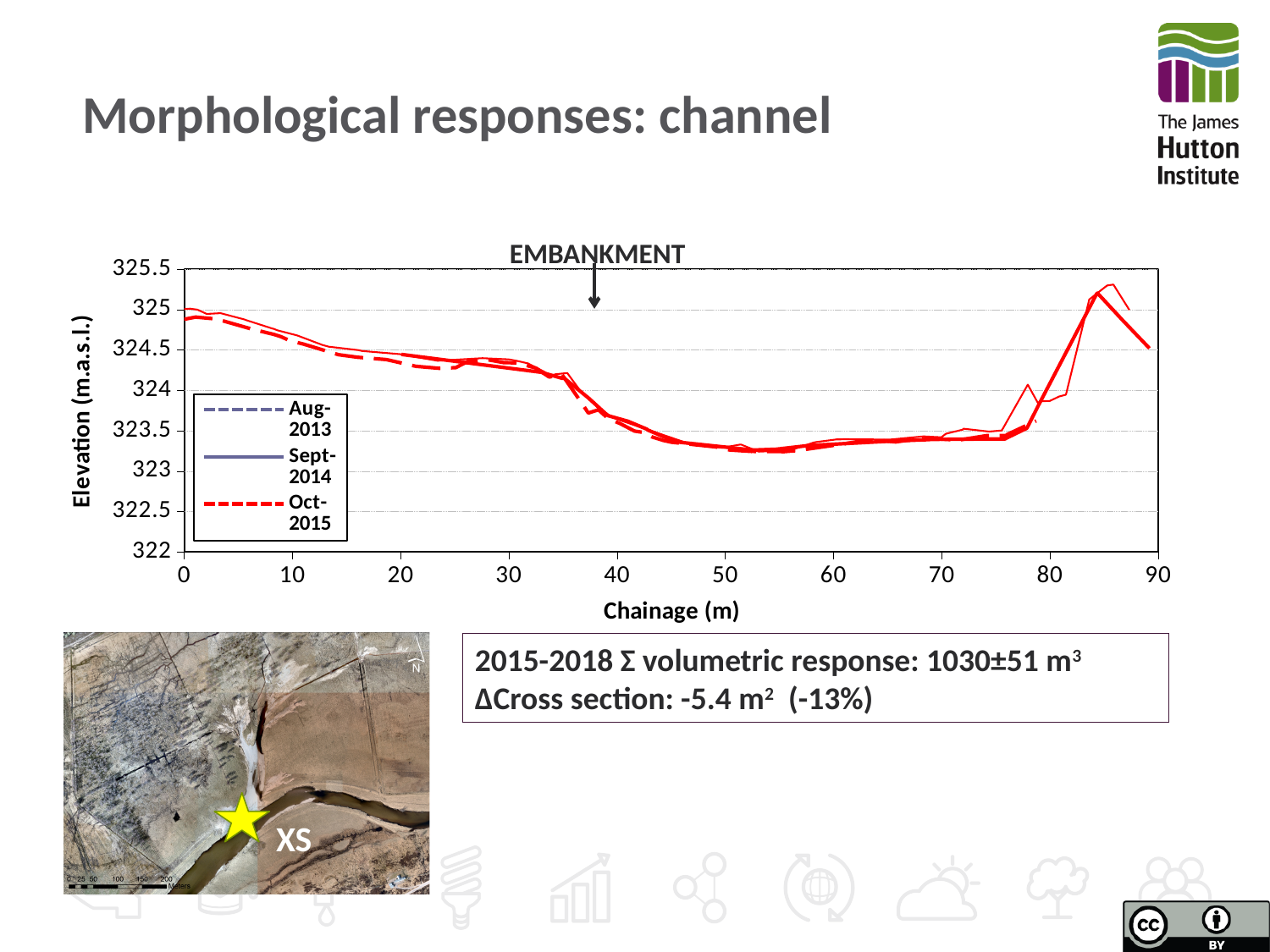
Is the Oct-2015 elevation at chainage 20 greater or less than 324? greater What kind of chart is shown on the slide? line chart Which three series are listed in the chart legend? Aug-2013, Sept-2014, Oct-2015 What is the label of the x axis of the chart? Chainage (m) Is the Oct-2015 elevation at chainage 0 greater or less than 324.5? greater Does the elevation rise or fall along the x axis between chainage 0 and chainage 50? fall How many series does the chart legend list? 3 Does the elevation rise or fall along the x axis between chainage 60 and chainage 85? rise Which is larger for Oct-2015: the elevation at chainage 10 or the elevation at chainage 60? chainage 10 Is the Oct-2015 elevation at chainage 40 greater or less than 324? less